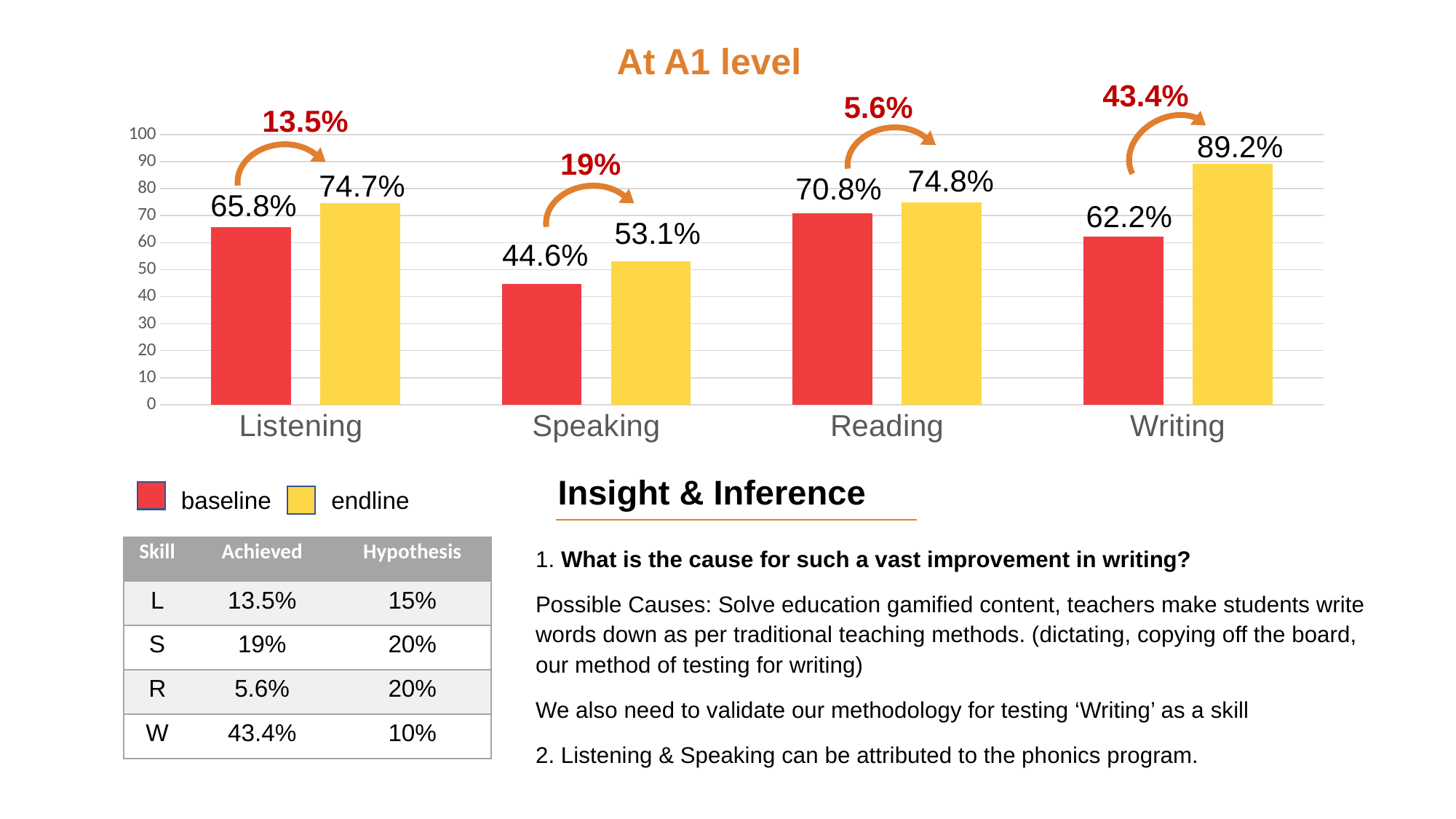
What is the baseline value for Listening? 65.8% How many series does the legend list? 2 Which skill has the lowest baseline value? Speaking What is the baseline value for Speaking? 44.6% What is the endline value for Reading? 74.8% What kind of chart is shown on the slide? Bar chart What is the difference between the endline and baseline values for Speaking? 8.5% How many skill categories are shown on the x axis? 4 Which is larger, the baseline value for Reading or the endline value for Listening? Endline value for Listening Which skill has the highest endline value? Writing What is the endline value for Writing? 89.2% Is the endline value for Speaking greater or less than 60? less